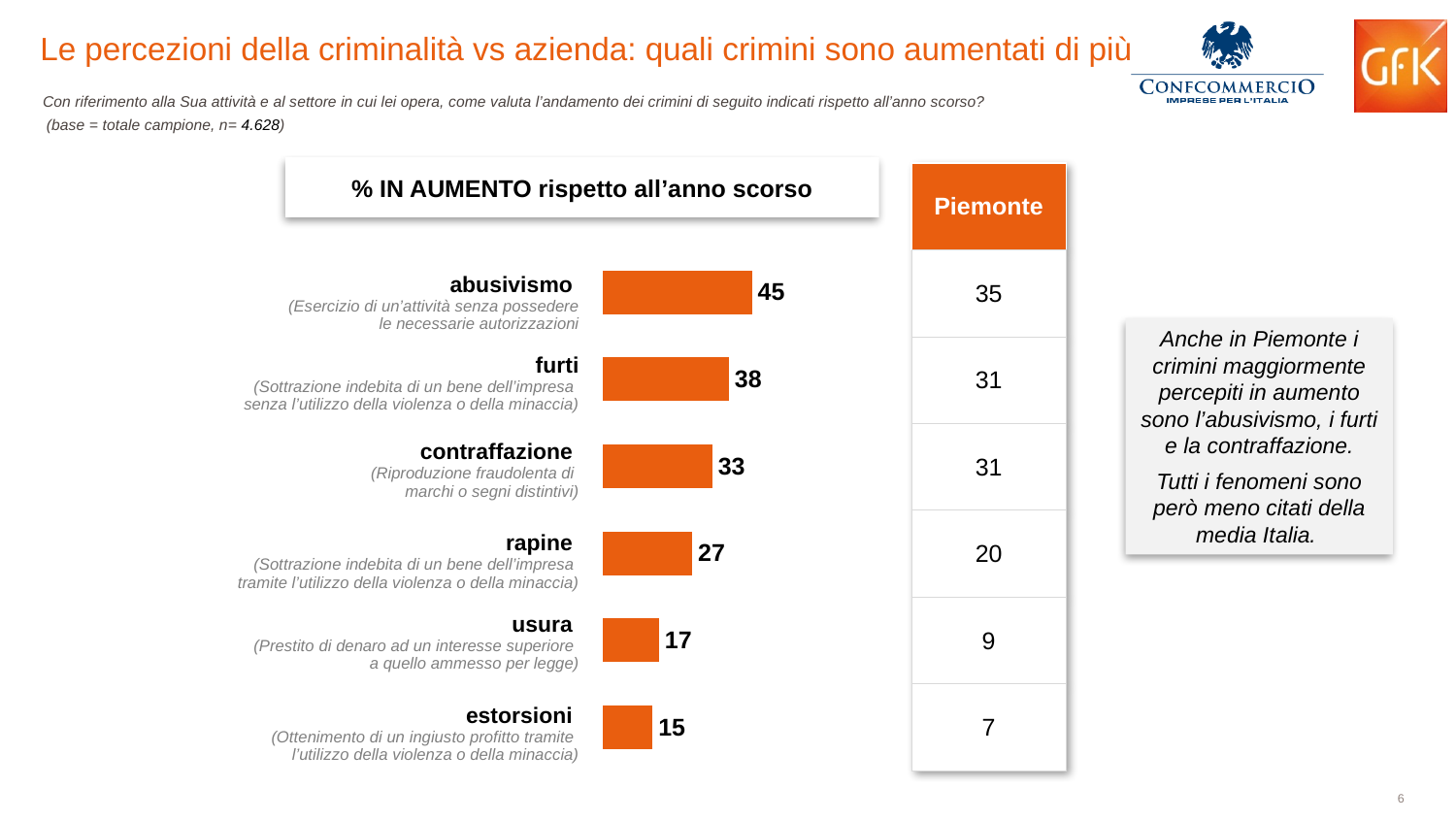
What is the title of the bar chart? % IN AUMENTO rispetto all'anno scorso Which has a larger value, rapine or usura? rapine What is the value shown for abusivismo in the bar chart? 45 What is the difference between the values for furti and contraffazione? 5 What is the value shown for rapine in the bar chart? 27 Which category has the highest value in the bar chart? abusivismo What is the value shown for usura in the bar chart? 17 Which category has the lowest value in the bar chart? estorsioni How many categories are shown in the bar chart? 6 What colour are the bars in the chart? orange What is the difference between the values for abusivismo and estorsioni? 30 What kind of chart is shown on the slide? bar chart